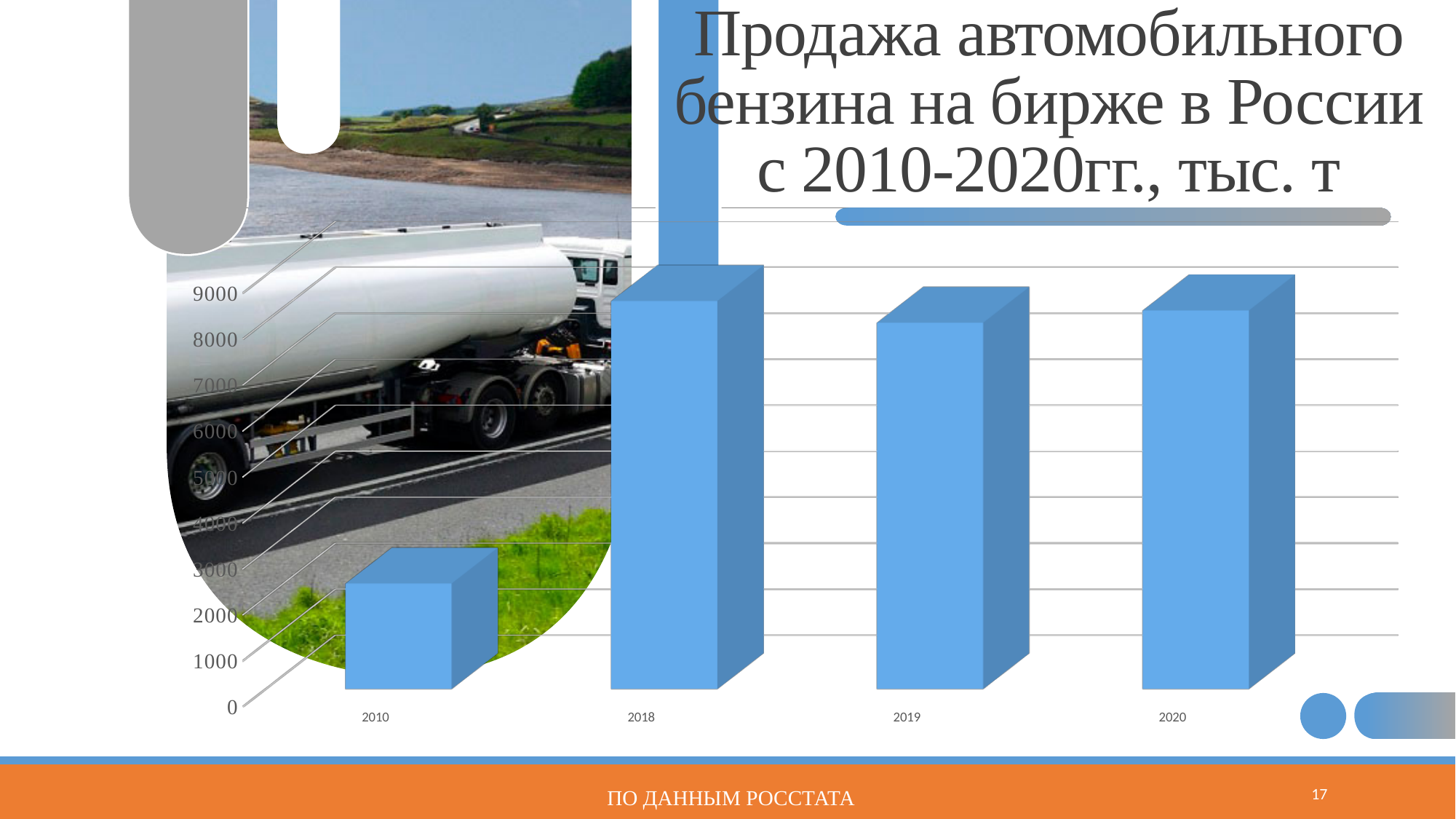
Is the value for 2020 greater or less than 7000? greater What is the title of the chart on the slide? Продажа автомобильного бензина на бирже в России с 2010-2020гг., тыс. т Is the value for 2018 greater or less than 8000? greater How many years (categories) are shown on the x axis of the chart? 4 Which is larger, the value for 2010 or the value for 2018? 2018 Which year has the lowest value in the chart? 2010 Which is larger, the value for 2018 or the value for 2019? 2018 Is the value for 2010 greater or less than 2000? greater Does the value rise or fall from 2010 to 2018? rise What kind of chart is shown on the slide? bar chart